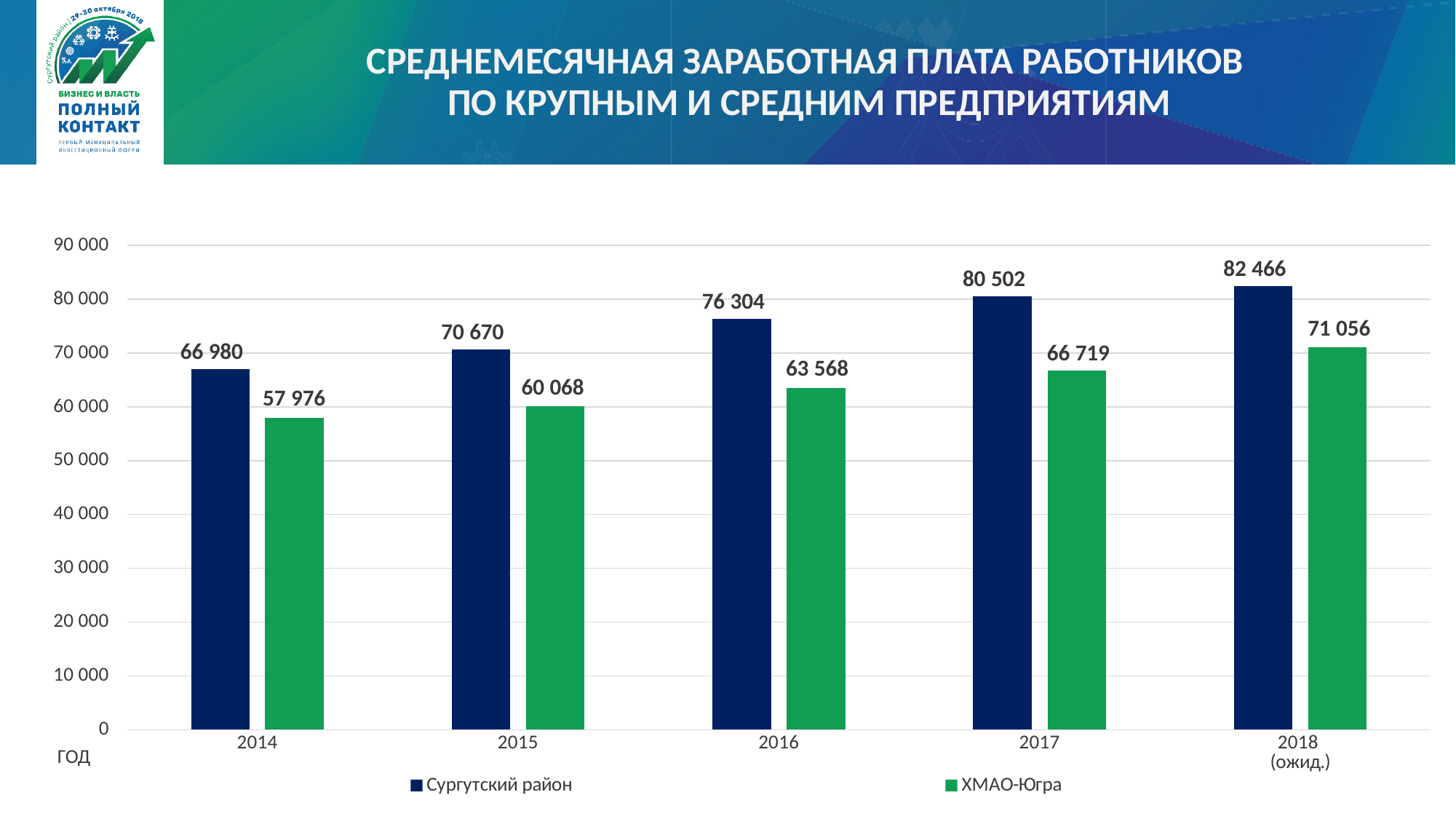
How many years are shown on the x axis? 5 What kind of chart is shown on the slide? bar chart Which is larger in 2015: Сургутский район or ХМАО-Югра? Сургутский район What is the value for ХМАО-Югра in 2018 (ожид.)? 71 056 What is the difference between Сургутский район and ХМАО-Югра in 2017? 13 783 In which year is the value for Сургутский район highest? 2018 (ожид.) What is the value for ХМАО-Югра in 2014? 57 976 In which year is the value for ХМАО-Югра lowest? 2014 Is the value for ХМАО-Югра in 2016 greater or less than 60 000? greater How many series does the legend list? 2 Do the values for Сургутский район rise or fall from 2014 to 2018? rise What is the value for Сургутский район in 2016? 76 304